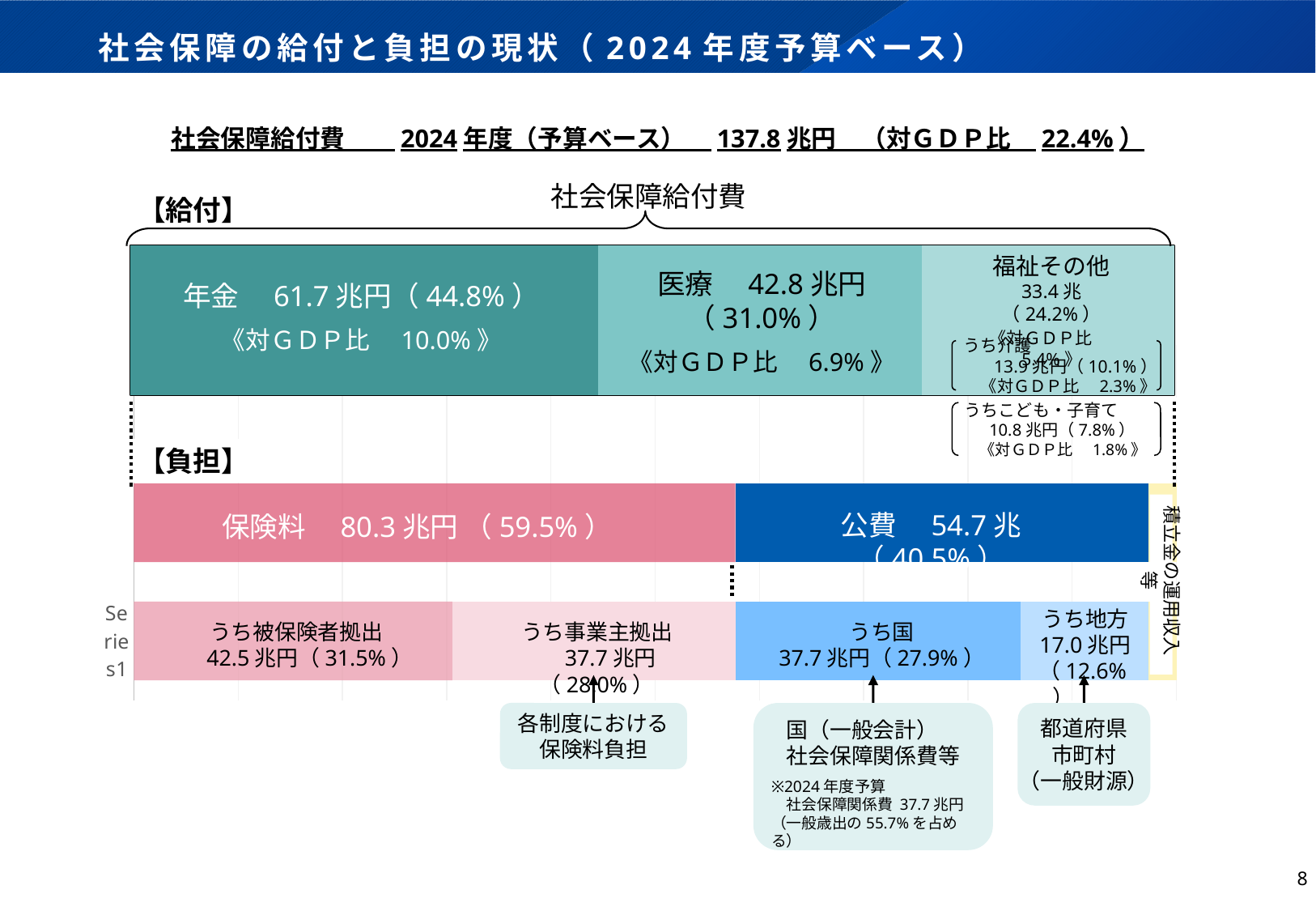
In the lower 【負担】 breakdown bar, what percentage is shown for うち地方? 12.6% Which segment of the 【給付】 bar is the largest? 年金 In the 【負担】 bar, what is the value shown for 保険料? 80.3兆円 What 対GDP比 value is shown for 年金 in the 【給付】 bar? 10.0% In the 【給付】 bar, what is the value shown for 年金? 61.7兆円 What is the difference between 保険料 (80.3兆円) and 公費 (54.7兆) in the 【負担】 bar? 25.6兆円 What kind of chart is used to show 給付 and 負担 on this slide? Stacked bar chart Which segment of the 【給付】 bar is the smallest? 福祉その他 In the 【給付】 bar, what percentage share is shown for 医療? 31.0% In the lower 【負担】 breakdown bar, what is the value shown for うち国? 37.7兆円 In the 【負担】 bar, which is larger, 保険料 or 公費? 保険料 What is the difference between 年金 (61.7兆円) and 医療 (42.8兆円) in the 【給付】 bar? 18.9兆円